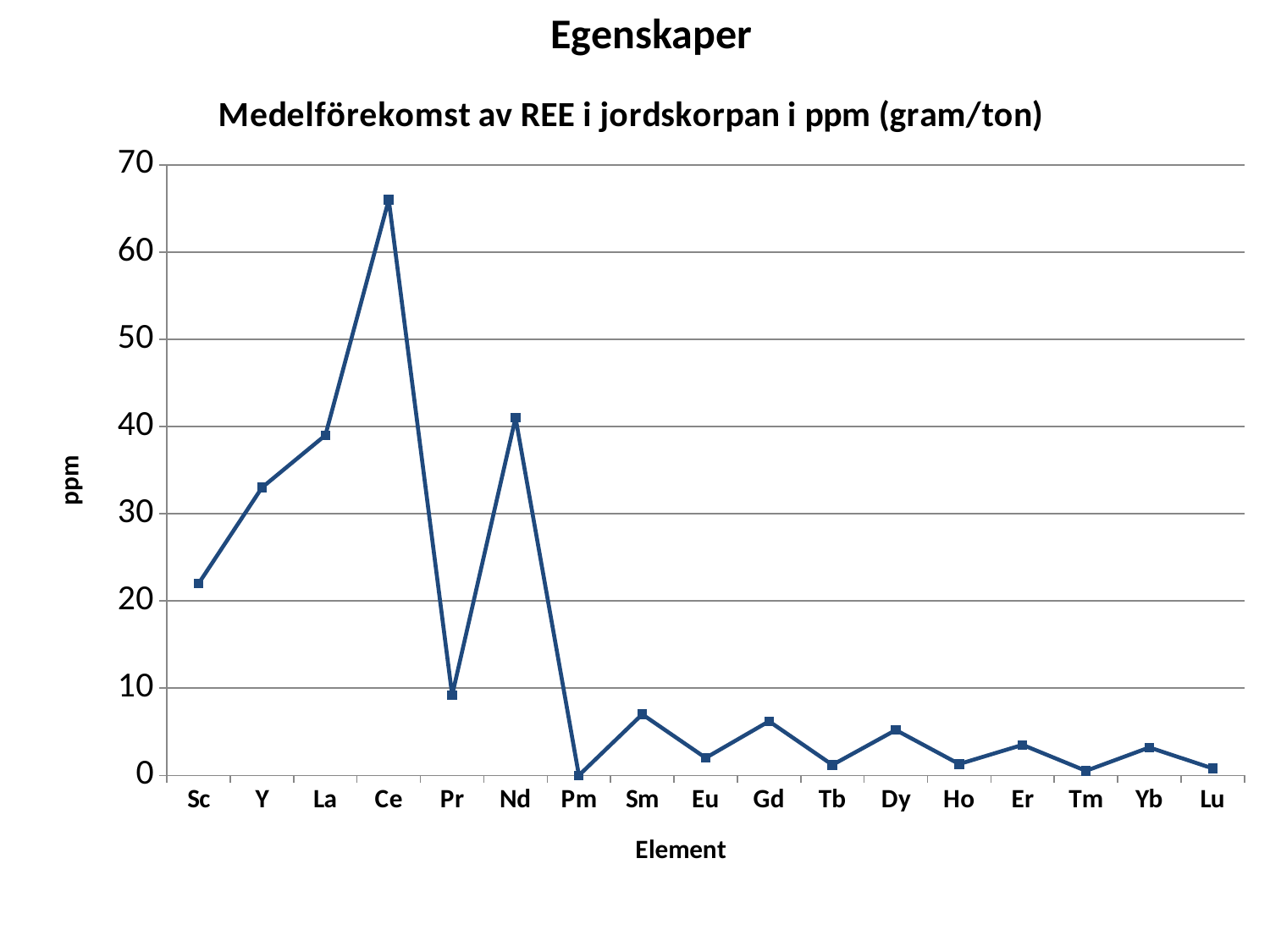
Which element has the lowest average occurrence in ppm? Pm Is the value for Y greater or less than 30? greater What kind of chart is shown on the slide? line chart Do the values rise or fall from Sc to Ce? rise What is the label on the y axis? ppm Is the value for Pr greater or less than 10? less Which has a higher value, Ce or Nd? Ce Which element has the highest average occurrence in ppm? Ce Is the value for Ce greater or less than 60? greater Which has a higher value, Sm or Eu? Sm How many elements are plotted along the x axis? 17